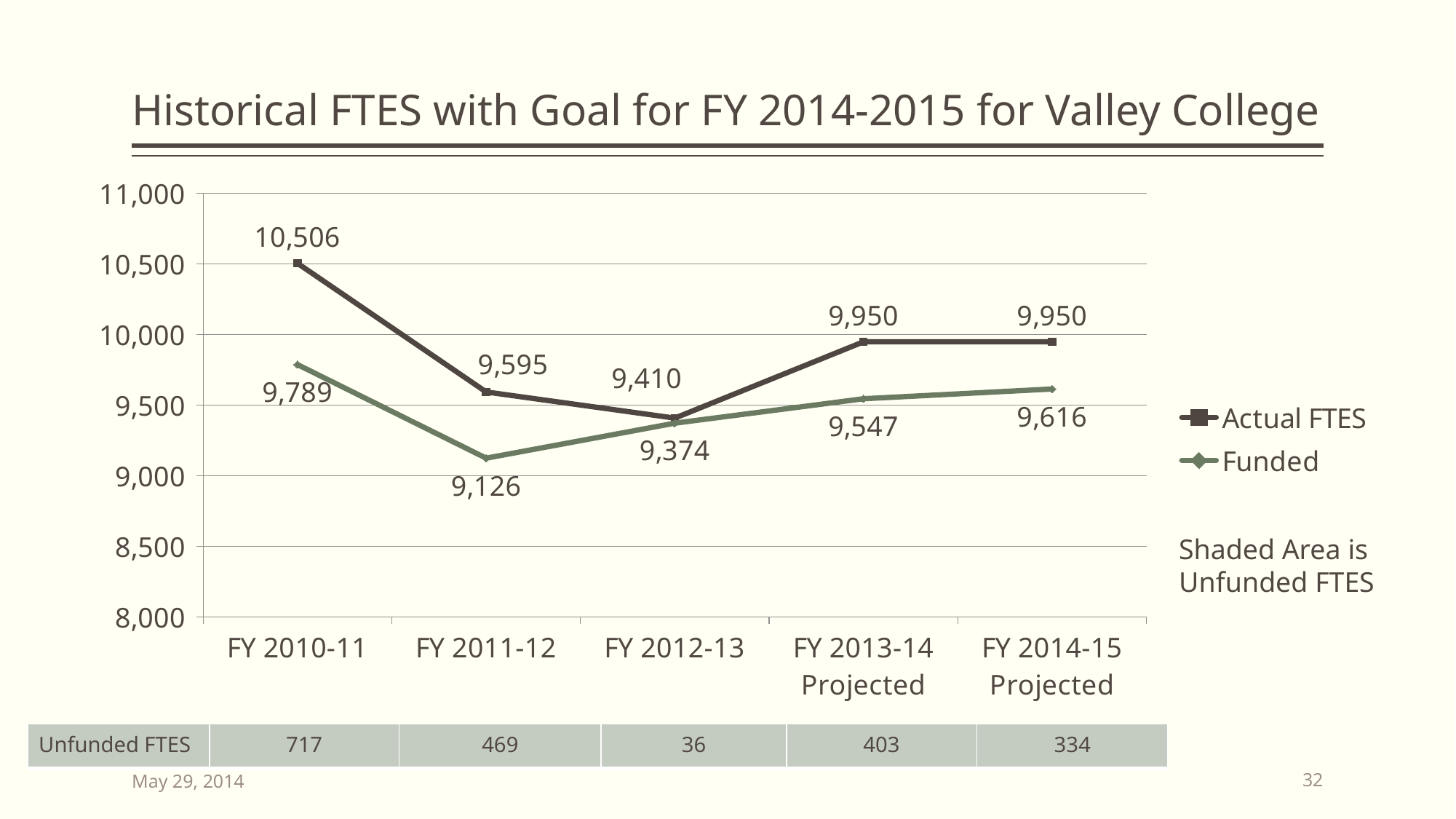
How many fiscal years are shown on the x axis? 5 What is the Funded value for FY 2011-12? 9,126 Which fiscal year has the lowest Funded value? FY 2011-12 Is the Funded value for FY 2013-14 Projected greater or less than 9,500? greater How many series does the legend list? 2 Does the Funded series rise or fall from FY 2011-12 to FY 2014-15 Projected? Rise What is the Funded value for FY 2014-15 Projected? 9,616 Which is larger in FY 2012-13, Actual FTES or Funded? Actual FTES What is the Actual FTES value for FY 2010-11? 10,506 Which fiscal year has the highest Actual FTES? FY 2010-11 What is the difference between Actual FTES and Funded in FY 2010-11? 717 What kind of chart is shown on the slide? Line chart